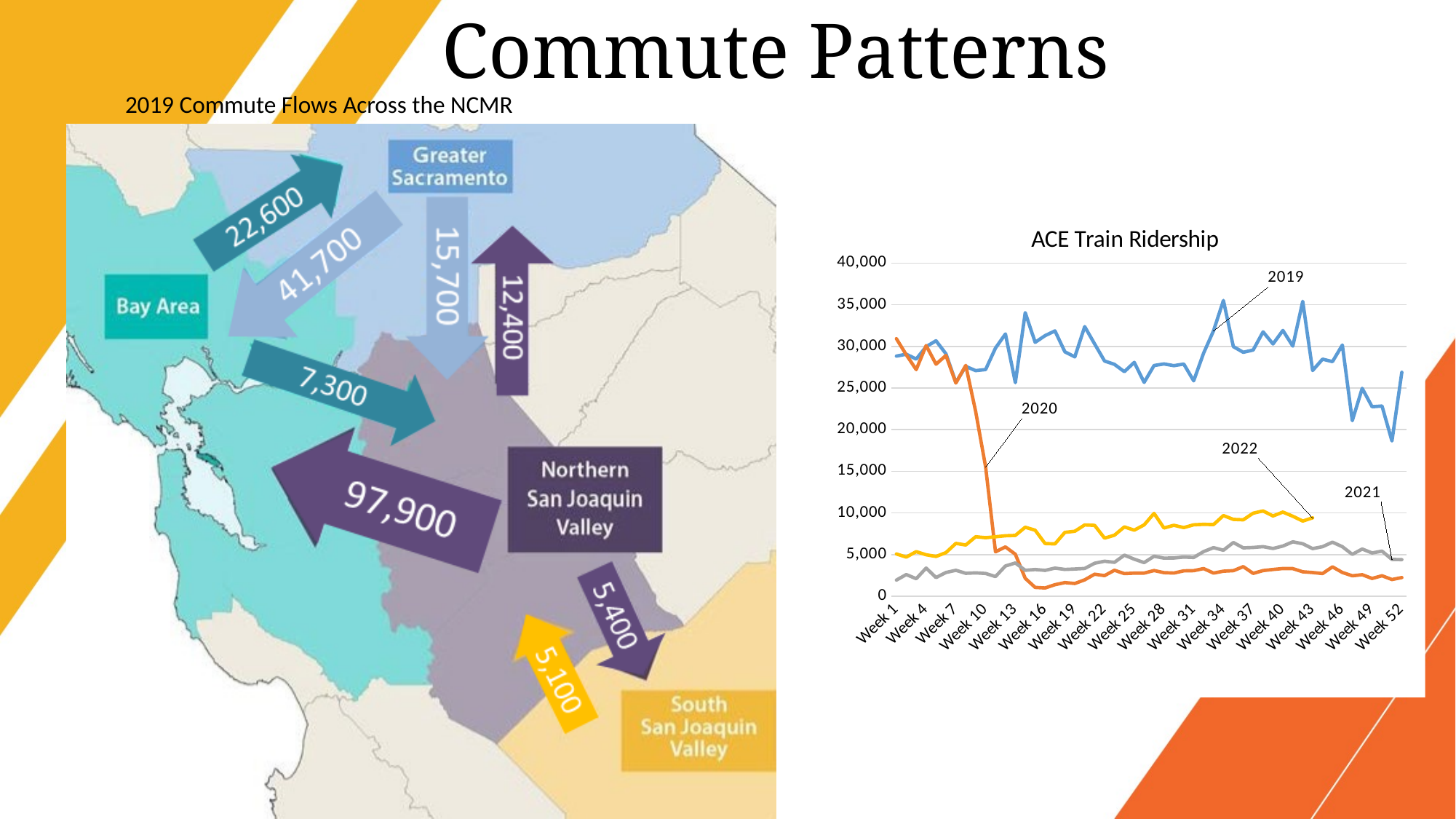
On the ACE Train Ridership chart, is the 2020 value at Week 16 greater or less than 5,000? less On the ACE Train Ridership chart, which year's line is lowest at Week 1? 2021 How many year series are labelled on the ACE Train Ridership chart? 4 On the ACE Train Ridership chart, is the 2019 value at Week 1 greater or less than 25,000? greater On the 2019 Commute Flows map, what is the commute flow from Greater Sacramento to the Bay Area? 41,700 On the ACE Train Ridership chart, does the 2020 line rise or fall between Week 10 and Week 13? fall What kind of chart is the ACE Train Ridership chart? line chart On the 2019 Commute Flows map, what is the difference between the Greater Sacramento to Bay Area flow (41,700) and the Bay Area to Greater Sacramento flow (22,600)? 19,100 On the ACE Train Ridership chart, which is larger at Week 31: the 2019 value or the 2022 value? 2019 On the ACE Train Ridership chart, is the 2021 value at Week 1 greater or less than 5,000? less On the 2019 Commute Flows map, what is the commute flow from Northern San Joaquin Valley to the Bay Area? 97,900 On the ACE Train Ridership chart, which year's line is highest across the weeks? 2019